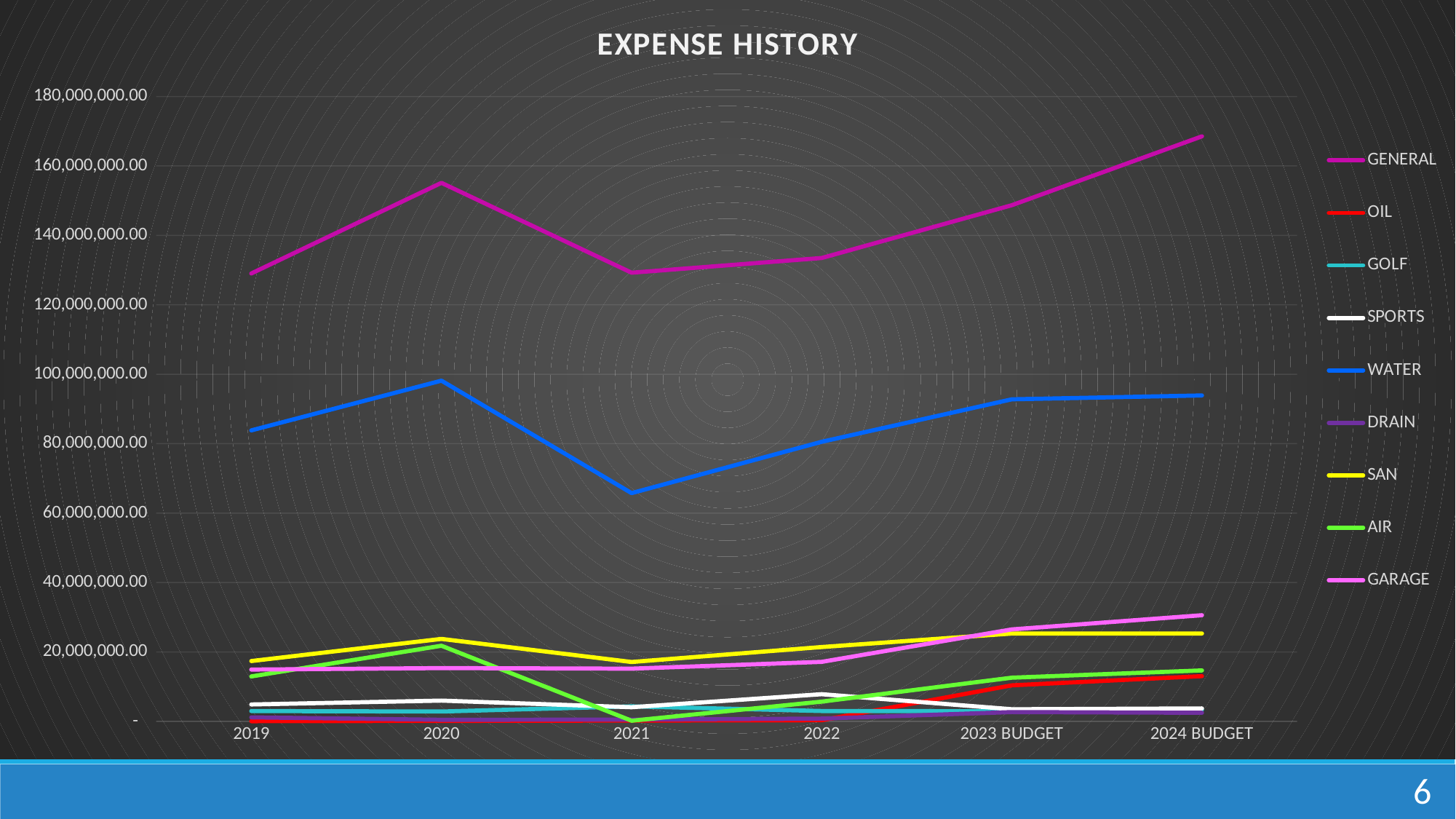
What is the title of the chart? EXPENSE HISTORY Is the value for GARAGE in 2024 BUDGET greater or less than 40,000,000.00? less Is the value for GENERAL in 2024 BUDGET greater or less than 160,000,000.00? greater How many points are there along the x axis? 6 Which series has the larger value in 2019, GENERAL or WATER? GENERAL In which year or budget period is the GENERAL series highest? 2024 BUDGET Is the value for WATER in 2021 greater or less than 80,000,000.00? less What kind of chart is shown on the slide? Line chart How many series does the legend list? 9 In which year or budget period is the WATER series lowest? 2021 Does the GENERAL series rise or fall from 2021 to 2024 BUDGET? Rises